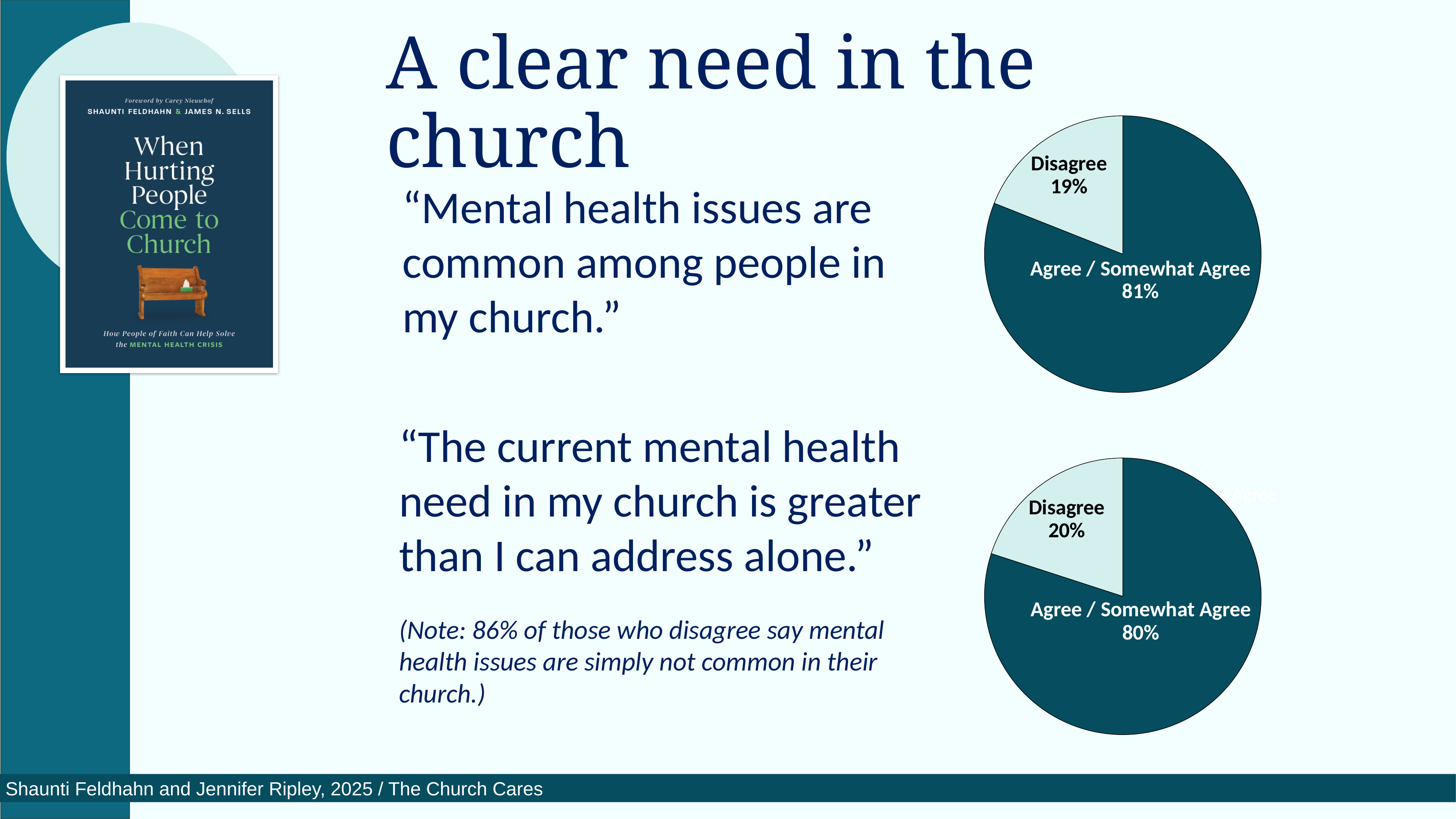
In the top pie chart, what percentage is labelled Agree / Somewhat Agree? 81% How many slices does the top pie chart have? 2 In the top pie chart, what percentage is labelled Disagree? 19% In the bottom pie chart, which slice is the smallest? Disagree In the bottom pie chart, what is the difference between the Agree / Somewhat Agree share and the Disagree share? 60% In the top pie chart, what colour is the Disagree slice? Light blue Which is larger: the Disagree share in the top pie chart or the Disagree share in the bottom pie chart? Bottom pie chart What kind of chart is the bottom chart on the slide? Pie chart In the bottom pie chart, what percentage is labelled Disagree? 20% In the top pie chart, what is the difference between the Agree / Somewhat Agree share and the Disagree share? 62% In the top pie chart, which slice is the largest? Agree / Somewhat Agree In the bottom pie chart, what percentage is labelled Agree / Somewhat Agree? 80%